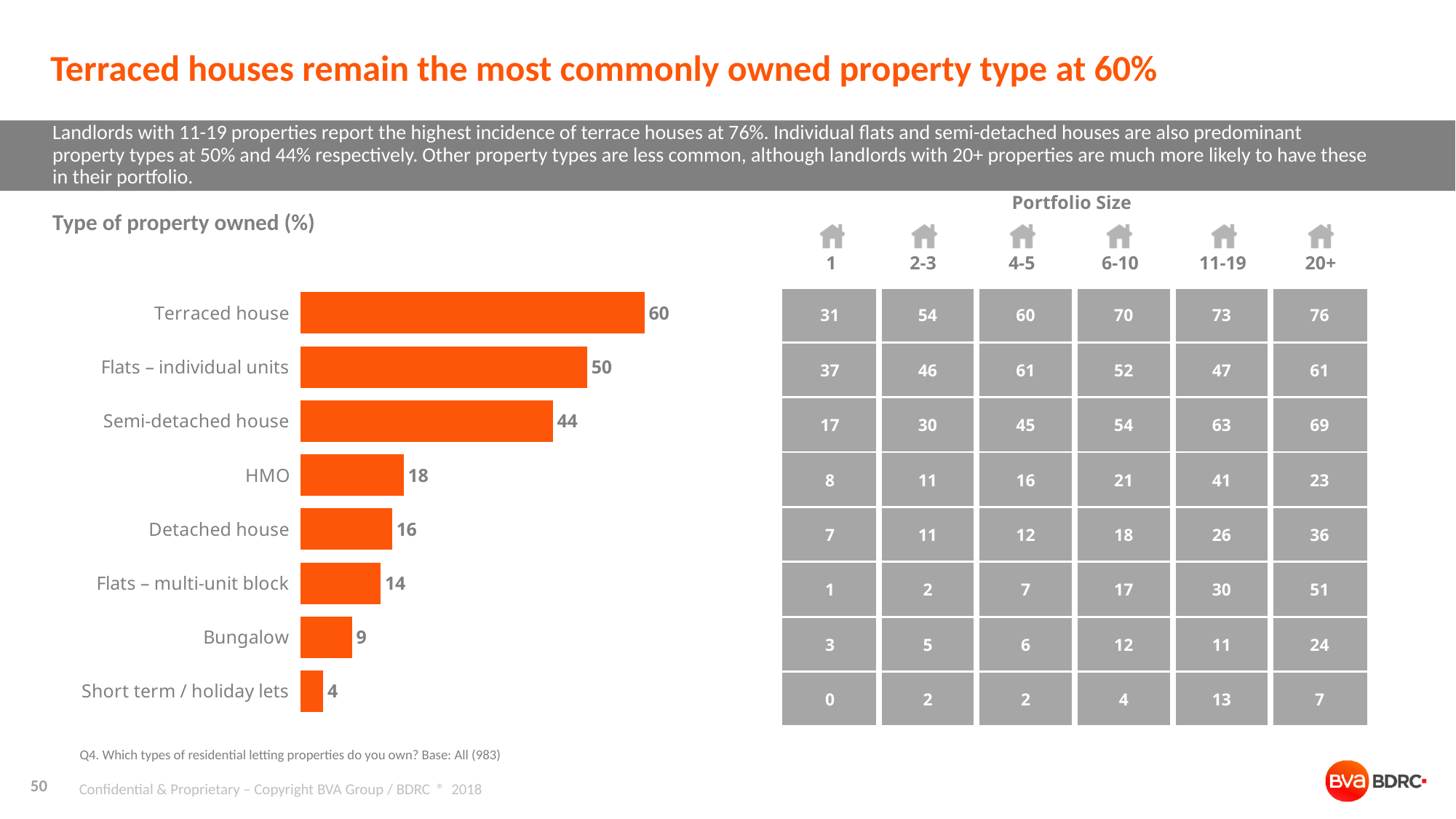
Which category has the highest value in the 'Type of property owned (%)' chart? Terraced house How many categories are shown in the 'Type of property owned (%)' chart? 8 Which category has the lowest value in the 'Type of property owned (%)' chart? Short term / holiday lets What is the value for Detached house in the 'Type of property owned (%)' chart? 16 What colour are the bars in the 'Type of property owned (%)' chart? Orange What is the difference between the values for Terraced house and Flats – individual units in the 'Type of property owned (%)' chart? 10 What is the value for Bungalow in the 'Type of property owned (%)' chart? 9 What kind of chart is the 'Type of property owned (%)' chart? Bar chart What is the difference between the values for Semi-detached house and Detached house in the 'Type of property owned (%)' chart? 28 Which is larger in the 'Type of property owned (%)' chart: HMO or Flats – multi-unit block? HMO What is the value for HMO in the 'Type of property owned (%)' chart? 18 What is the value for Terraced house in the 'Type of property owned (%)' chart? 60